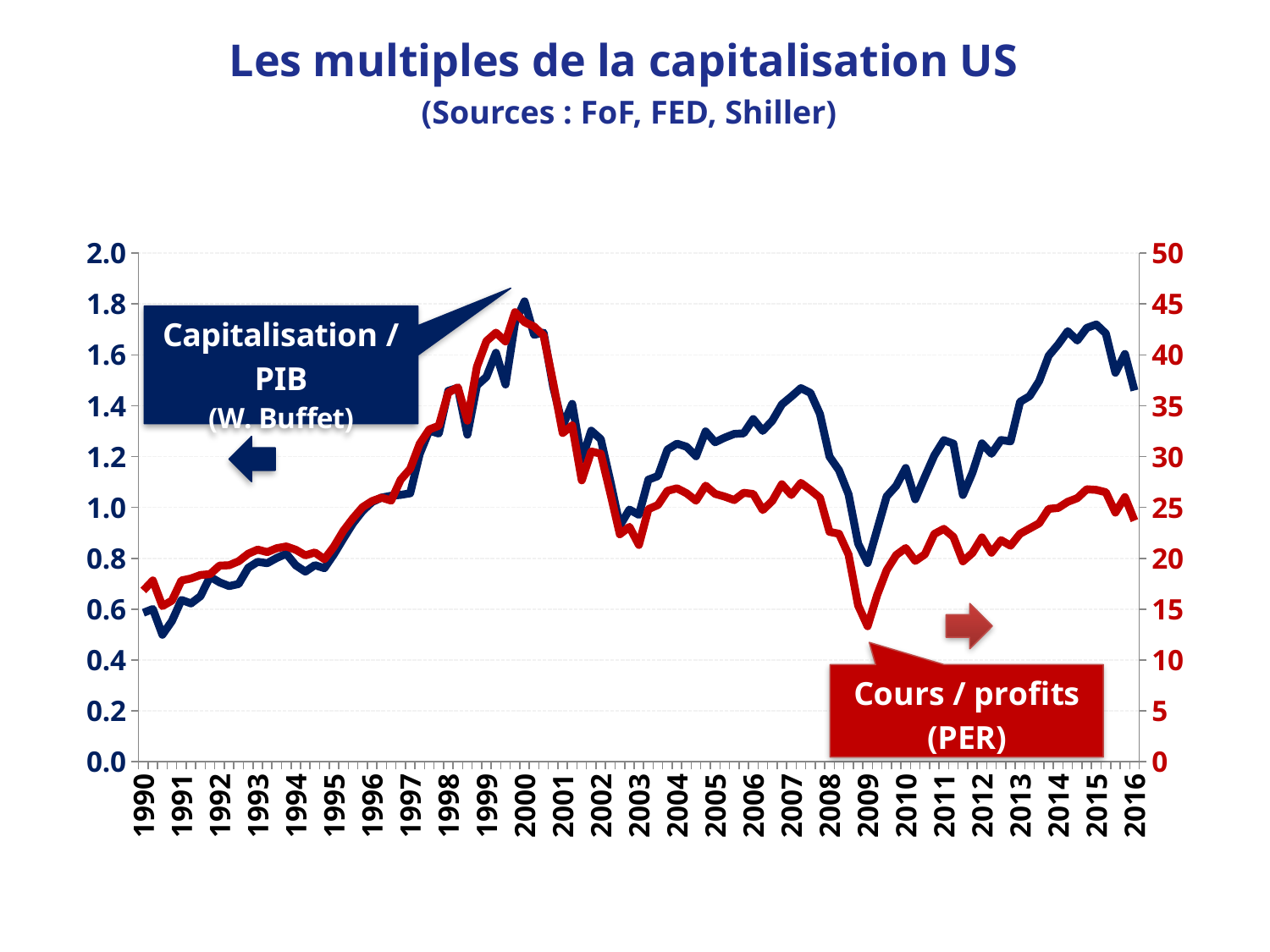
In which year does the Capitalisation / PIB series reach its highest value? 2000 Is the Cours / profits (PER) value in 2009 greater or less than 20? less What is the title of the chart? Les multiples de la capitalisation US In which year does the Cours / profits (PER) series reach its lowest value? 2009 Is the Capitalisation / PIB value in 2016 greater or less than 1.0? greater Is the Capitalisation / PIB value in 1990 greater or less than 1.0? less Between 1995 and 2000, does the Capitalisation / PIB series rise or fall? rise What type of chart is shown on the slide? line chart Between 2000 and 2003, does the Cours / profits (PER) series rise or fall? fall How many data series are plotted on the chart? 2 Which series is plotted with the dark blue line? Capitalisation / PIB